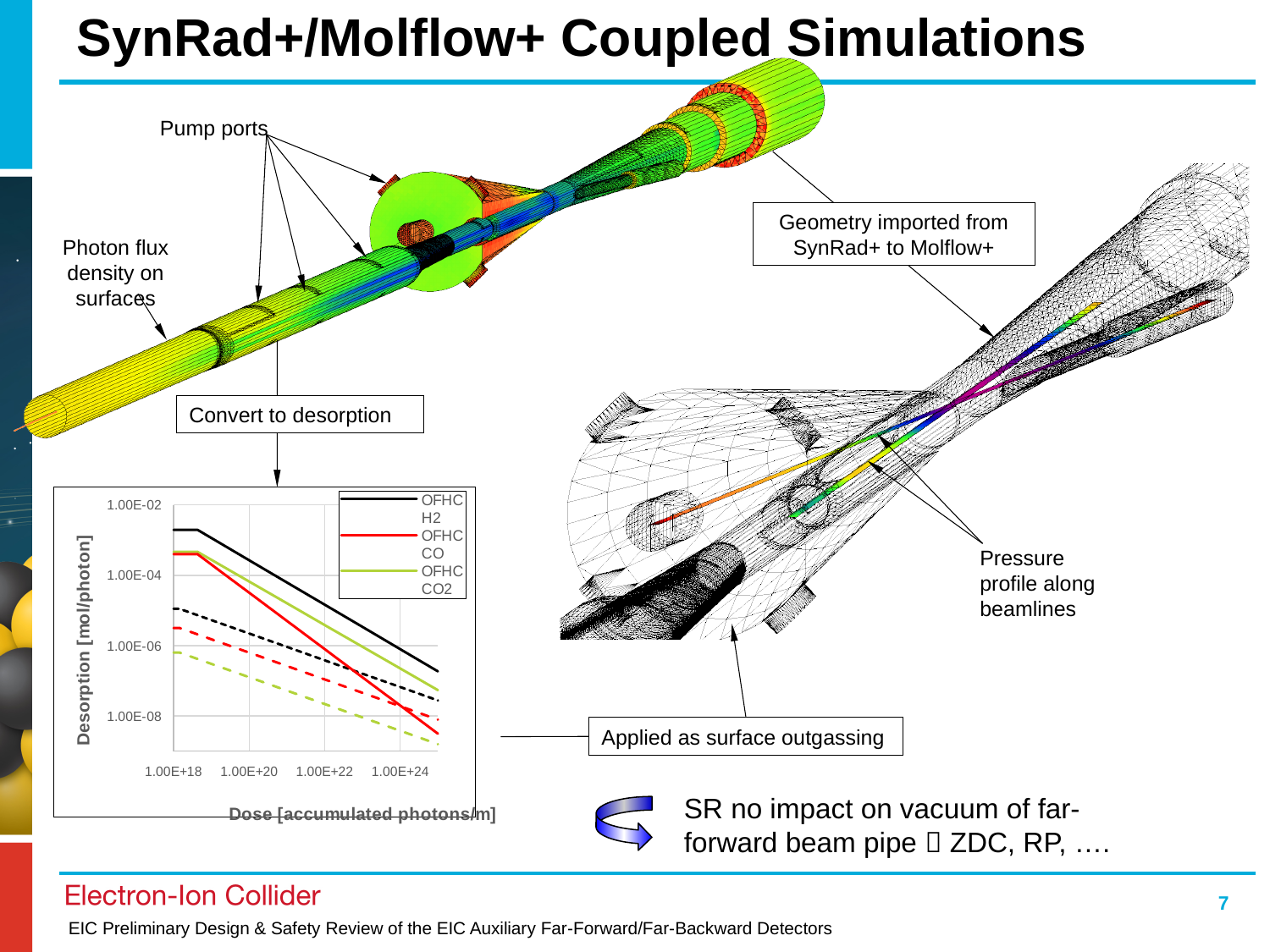
What is the lowest tick label shown on the chart's y axis? 1.00E-08 Is the desorption value for OFHC H2 at a dose of 1.00E+18 greater or less than 1.00E-02? less Do the desorption values rise or fall as dose increases along the x axis? fall Which series are listed in the chart legend? OFHC H2, OFHC CO, OFHC CO2 At a dose of 1.00E+24, which is larger: the desorption for OFHC H2 or for OFHC CO? OFHC H2 Which series has the highest desorption across the plotted dose range? OFHC H2 Is the desorption value for OFHC H2 at a dose of 1.00E+18 greater or less than 1.00E-04? greater What is the label of the chart's y axis? Desorption [mol/photon] What kind of chart is shown on the slide? line chart How many series does the chart legend list? 3 How many tick labels are shown on the chart's x axis? 4